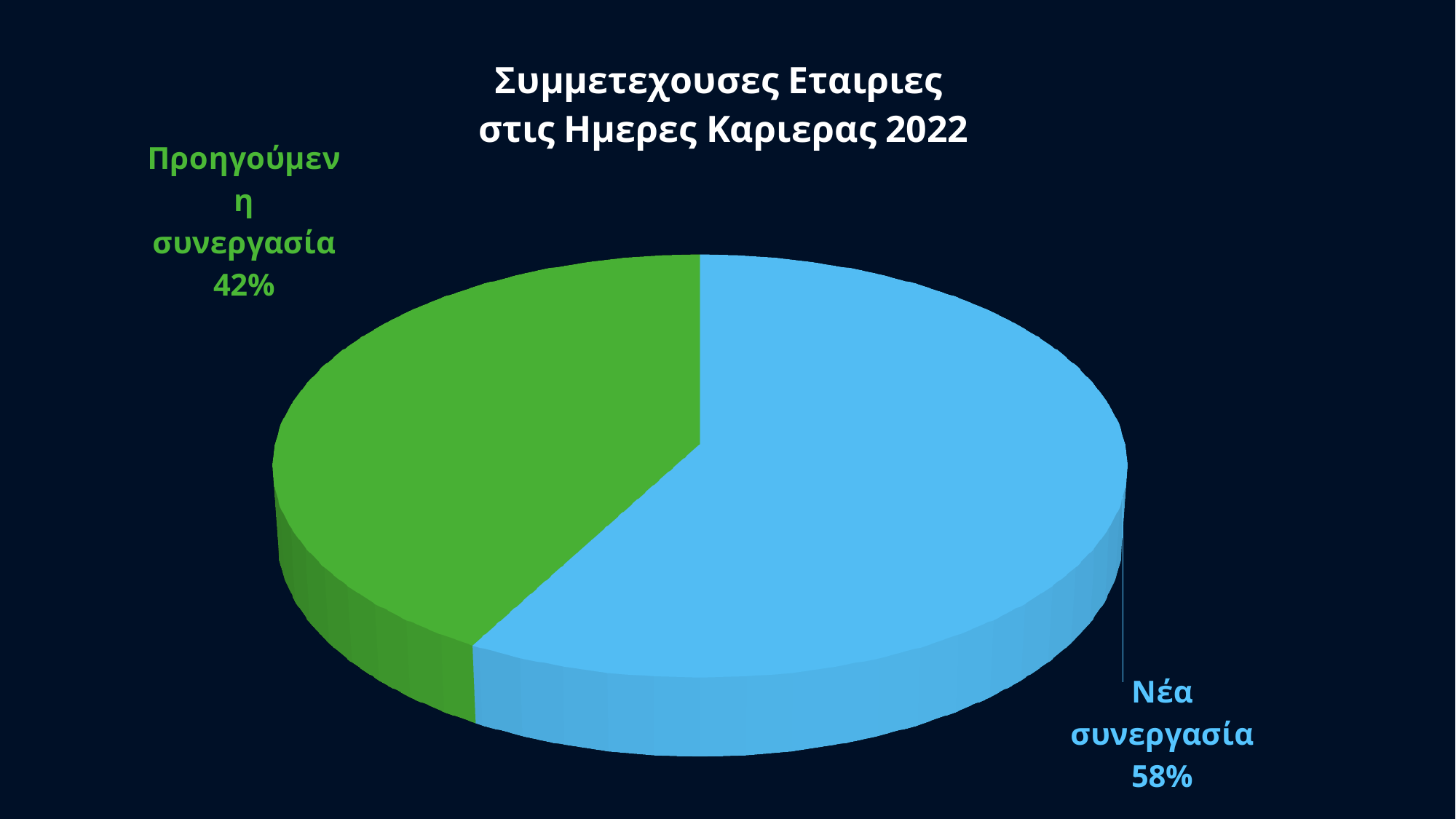
What kind of chart is shown on the slide? Pie chart What is the title of the chart? Συμμετεχουσες Εταιριες στις Ημερες Καριερας 2022 Is the share for Προηγούμενη συνεργασία greater or less than 50%? less Which is larger, the slice for Νέα συνεργασία or the slice for Προηγούμενη συνεργασία? Νέα συνεργασία What share of the pie does Προηγούμενη συνεργασία represent? 42% What colour is the slice for Νέα συνεργασία? Blue What share of the pie does Νέα συνεργασία represent? 58% How many slices does the pie chart have? 2 What is the difference in percentage points between Νέα συνεργασία and Προηγούμενη συνεργασία? 16 Which category has the smallest slice of the pie? Προηγούμενη συνεργασία Which category has the largest slice of the pie? Νέα συνεργασία